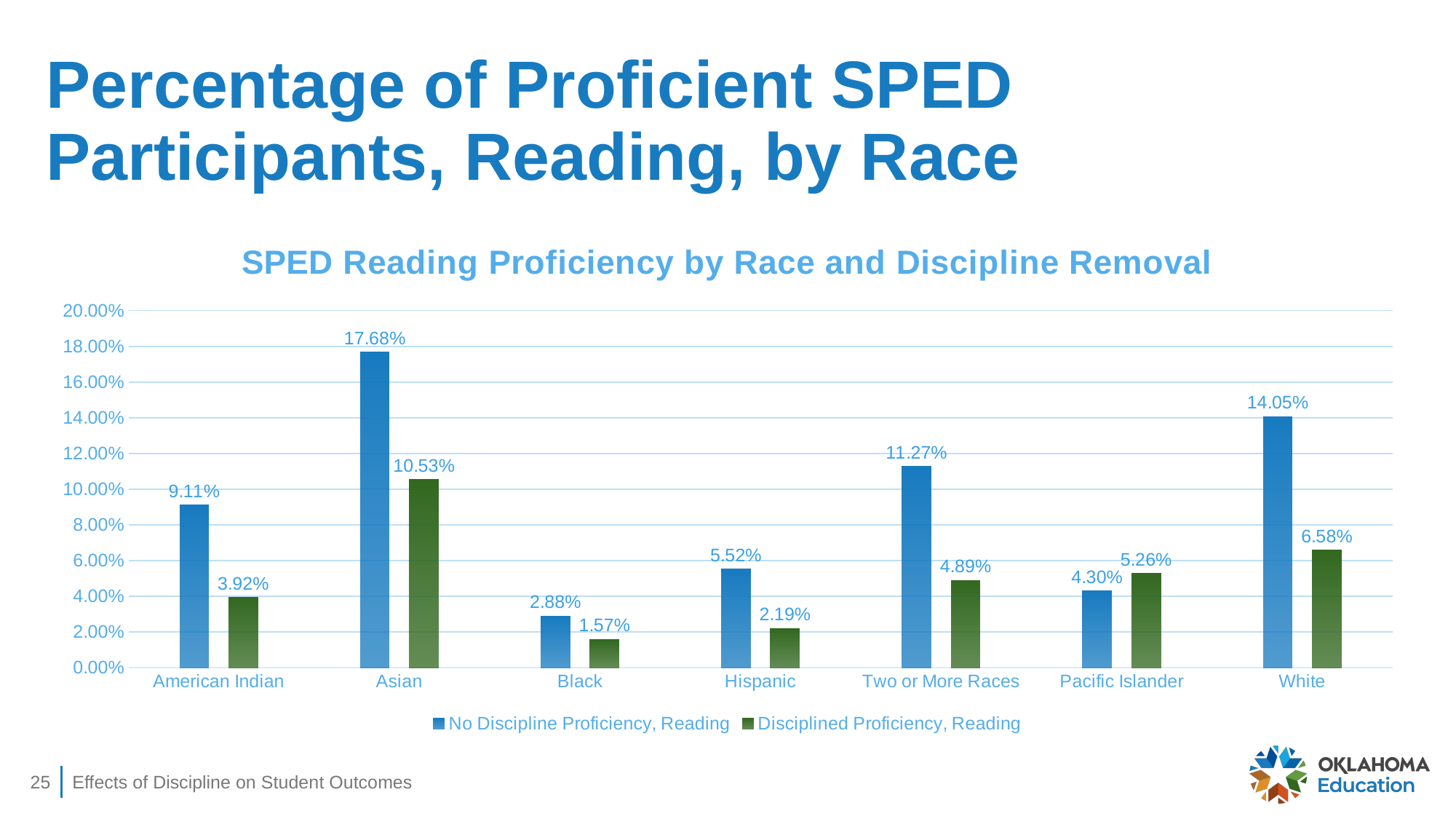
What is the Disciplined Proficiency, Reading value for White? 6.58% What kind of chart is shown on the slide? Bar chart Is the No Discipline Proficiency, Reading value for White greater or less than 12.00%? greater What is the title of the chart? SPED Reading Proficiency by Race and Discipline Removal What is the No Discipline Proficiency, Reading value for Asian? 17.68% What is the Disciplined Proficiency, Reading value for Black? 1.57% Which race has the highest No Discipline Proficiency, Reading value? Asian For Pacific Islander, which is larger: the No Discipline Proficiency, Reading value or the Disciplined Proficiency, Reading value? Disciplined Proficiency, Reading How many race categories are shown on the x axis? 7 How many series does the legend list? 2 Which race has the lowest Disciplined Proficiency, Reading value? Black What is the difference between the No Discipline and Disciplined Proficiency, Reading values for Asian? 7.15%